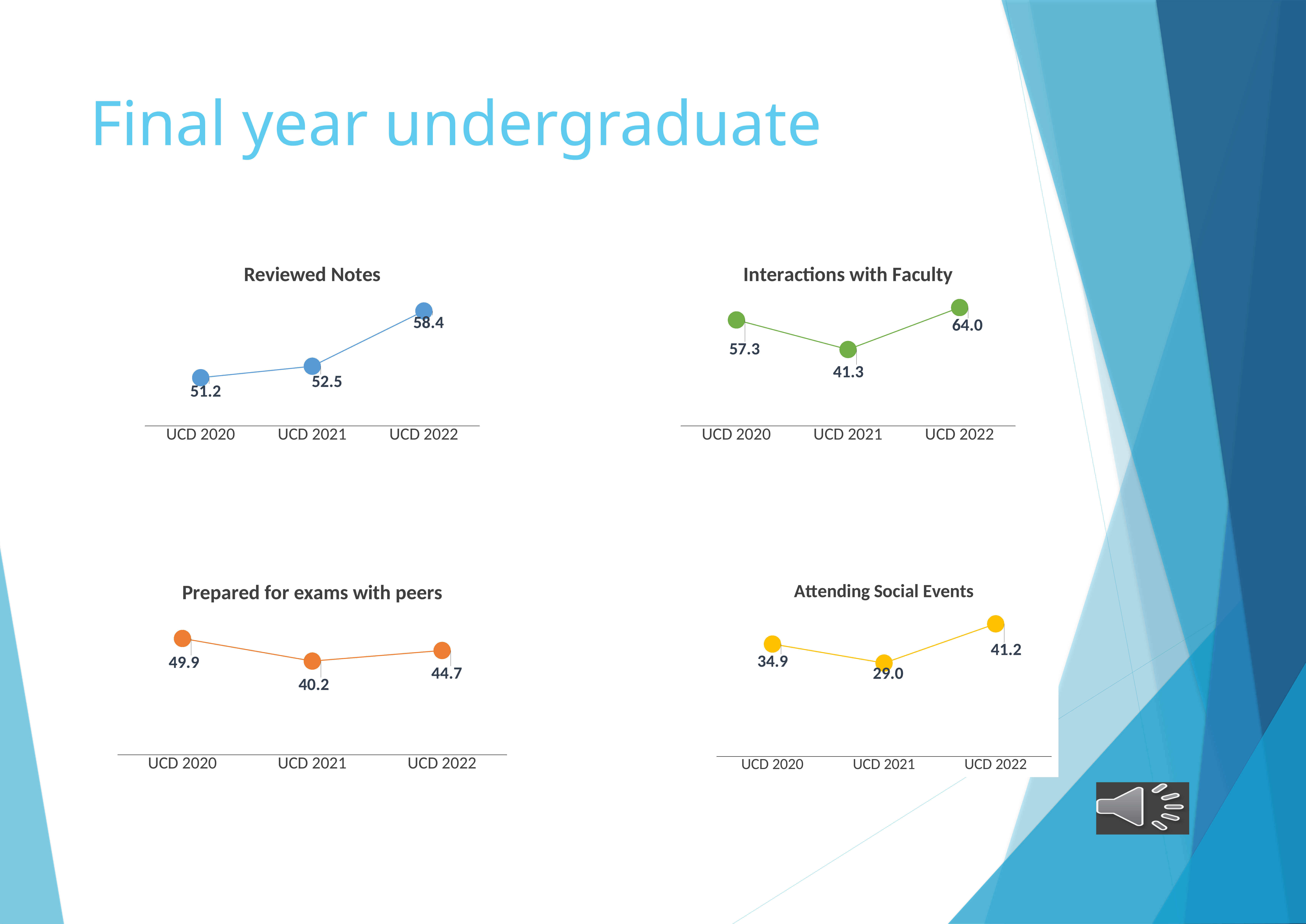
In the 'Prepared for exams with peers' chart, what is the value for UCD 2020? 49.9 In the 'Prepared for exams with peers' chart, what is the difference between the UCD 2020 and UCD 2021 values? 9.7 In the 'Interactions with Faculty' chart, which is larger: the value for UCD 2020 or UCD 2022? UCD 2022 In the 'Attending Social Events' chart, what is the value for UCD 2022? 41.2 What kind of chart is 'Reviewed Notes'? Line chart In the 'Reviewed Notes' chart, what is the value for UCD 2022? 58.4 How many data points are plotted in the 'Attending Social Events' chart? 3 In the 'Interactions with Faculty' chart, which year has the highest value? UCD 2022 In the 'Reviewed Notes' chart, do the values rise or fall from UCD 2020 to UCD 2022? Rise In the 'Interactions with Faculty' chart, what is the value for UCD 2021? 41.3 In the 'Reviewed Notes' chart, what is the difference between the UCD 2022 and UCD 2020 values? 7.2 In the 'Attending Social Events' chart, which year has the lowest value? UCD 2021